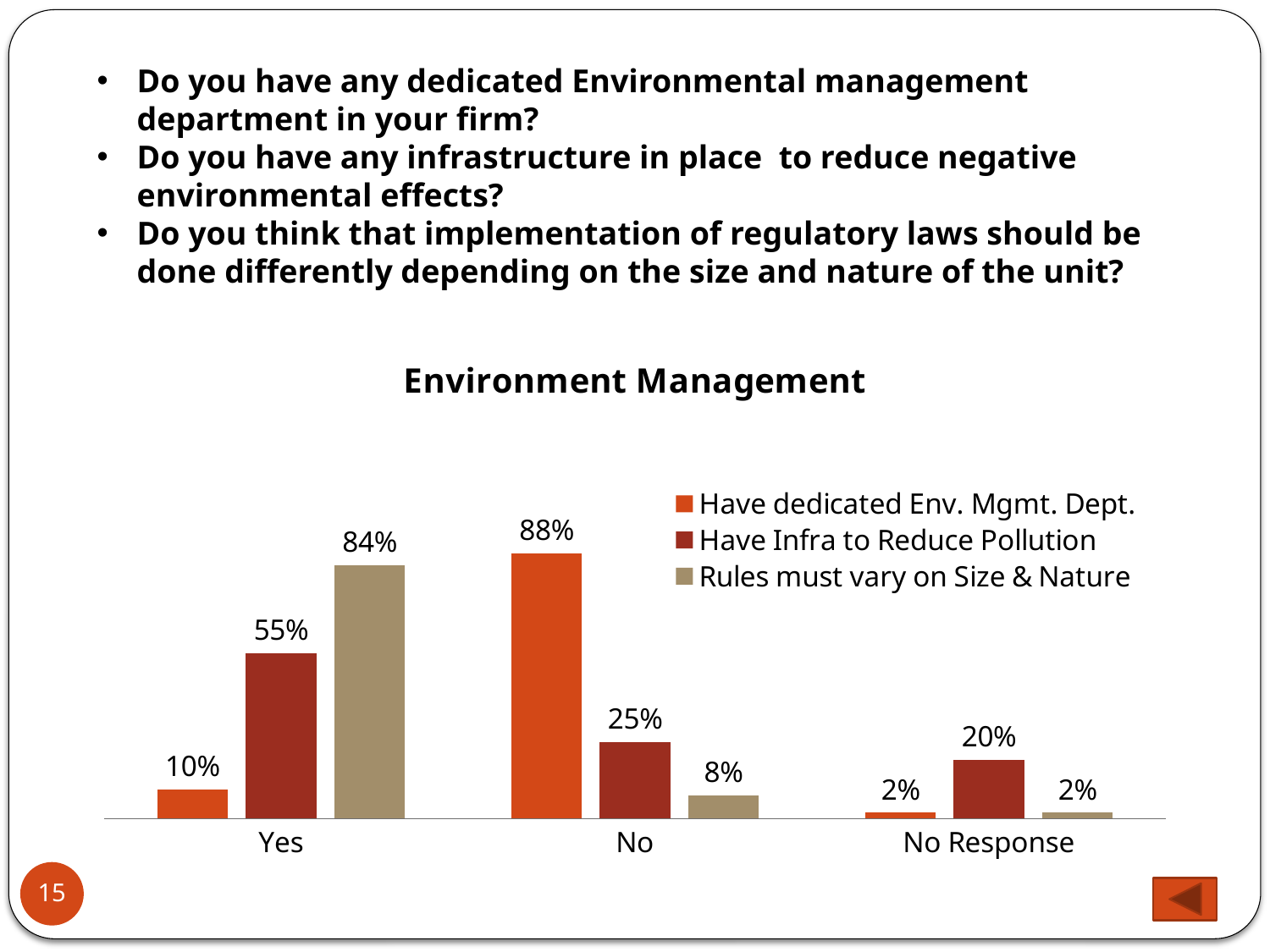
What is the value for "Have Infra to Reduce Pollution" in the No Response category? 20% How many series does the legend list? 3 How many categories are shown on the x axis? 3 What is the value for "Have Infra to Reduce Pollution" in the No category? 25% What is the value for "Have dedicated Env. Mgmt. Dept." in the Yes category? 10% In the Yes category, which is larger: "Have Infra to Reduce Pollution" or "Rules must vary on Size & Nature"? Rules must vary on Size & Nature Which category has the highest value for "Have dedicated Env. Mgmt. Dept."? No What is the title of the chart? Environment Management Which category has the lowest value for "Rules must vary on Size & Nature"? No Response What is the difference between the "Have dedicated Env. Mgmt. Dept." values for No and Yes? 78% What kind of chart is shown on the slide? Bar chart What is the value for "Rules must vary on Size & Nature" in the Yes category? 84%